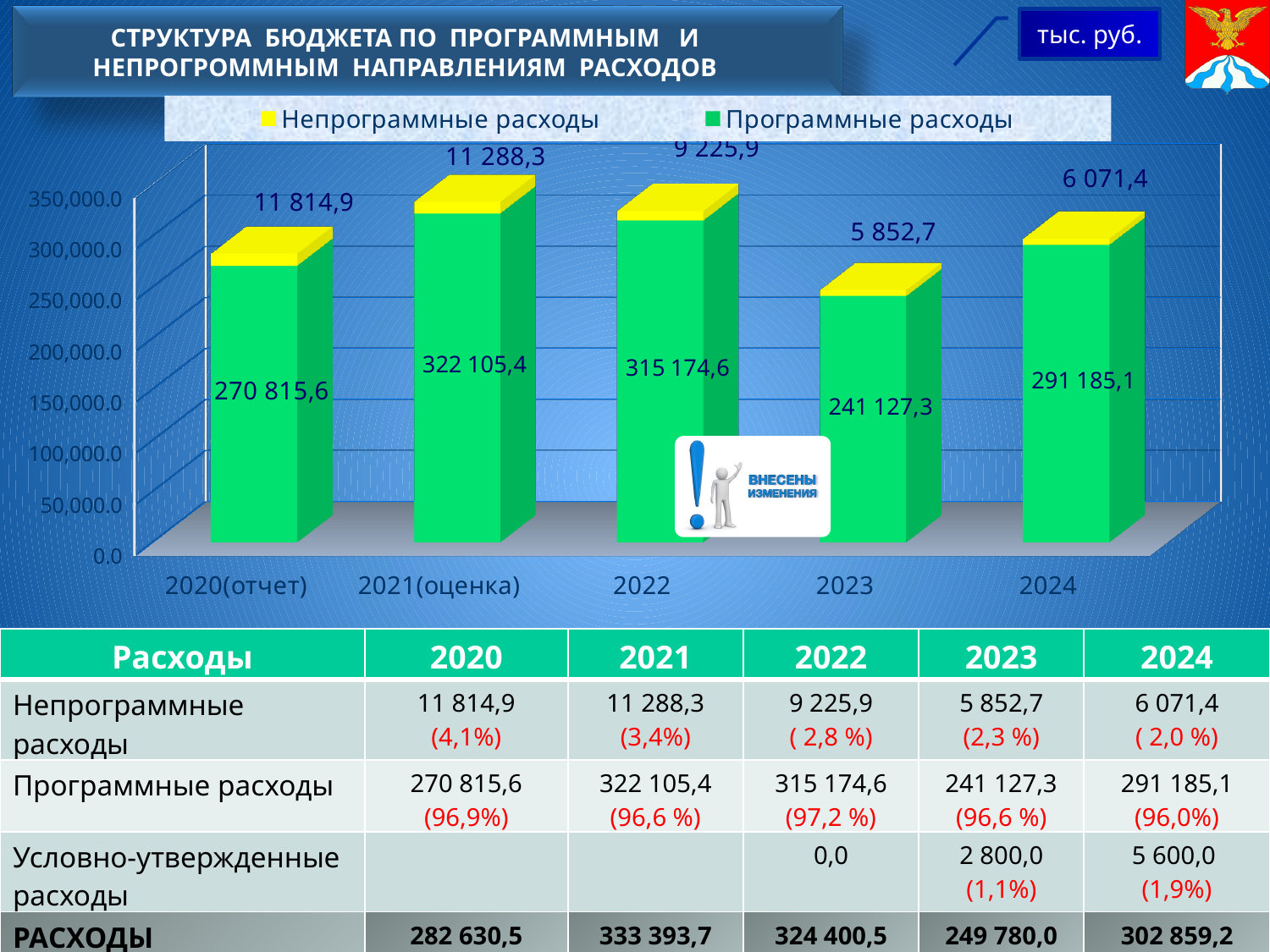
Which category has the highest value of Программные расходы? 2021(оценка) What type of chart is shown on the slide? Bar chart How many series does the chart legend list? 2 Which is larger: Непрограммные расходы in 2020(отчет) or in 2021(оценка)? 2020(отчет) How many categories are shown along the x axis of the chart? 5 Which category has the lowest value of Непрограммные расходы? 2023 What is the value of Непрограммные расходы for 2023? 5 852,7 What is the value of Программные расходы for 2024? 291 185,1 Which colour represents Непрограммные расходы in the chart? Yellow What is the total of the stacked bar for 2020(отчет)? 282 630,5 What is the value of Программные расходы for 2021(оценка)? 322 105,4 What is the difference between Программные расходы in 2022 and in 2023? 74 047,3